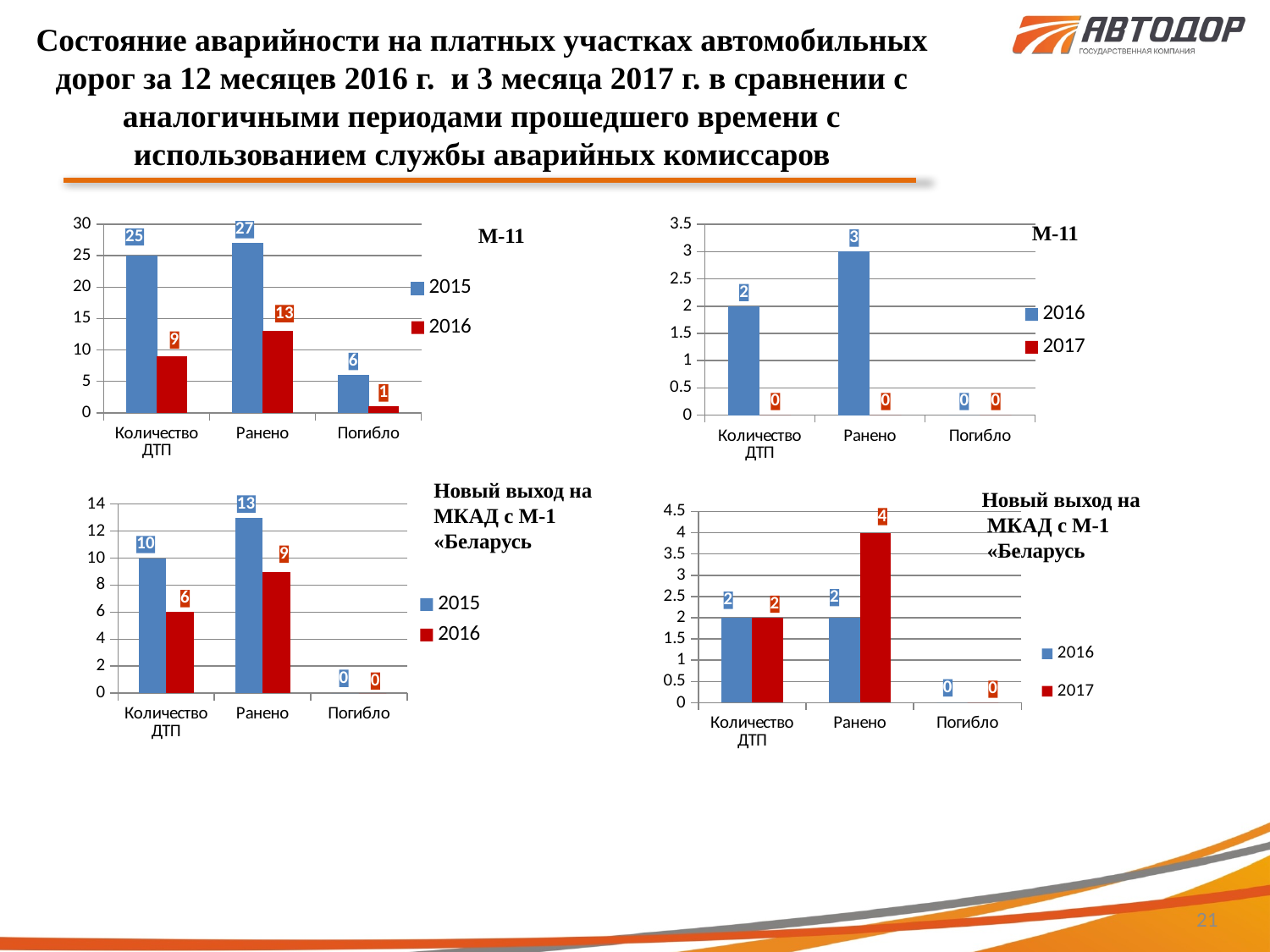
In the bottom-left chart for Новый выход на МКАД с М-1 «Беларусь» (2015 vs 2016), which is larger for Количество ДТП: the 2015 value or the 2016 value? 2015 In the top-left M-11 chart (2015 vs 2016), which category has the lowest 2016 value? Погибло In the top-right M-11 chart (2016 vs 2017), what is the 2016 value for Ранено? 3 In the top-right M-11 chart (2016 vs 2017), what is the 2017 value for Количество ДТП? 0 In the top-left M-11 chart (2015 vs 2016), what is the 2016 value for Ранено? 13 What type of chart is the top-left M-11 chart? Bar chart In the top-left M-11 chart (2015 vs 2016), what is the difference between the 2015 and 2016 values for Количество ДТП? 16 In the bottom-right chart for Новый выход на МКАД с М-1 «Беларусь» (2016 vs 2017), how many categories are shown on the x axis? 3 In the bottom-right chart for Новый выход на МКАД с М-1 «Беларусь» (2016 vs 2017), what is the 2017 value for Ранено? 4 In the top-right M-11 chart (2016 vs 2017), how many series does the legend list? 2 In the bottom-left chart for Новый выход на МКАД с М-1 «Беларусь» (2015 vs 2016), what is the 2015 value for Ранено? 13 In the top-left M-11 chart (2015 vs 2016), what is the 2015 value for Количество ДТП? 25